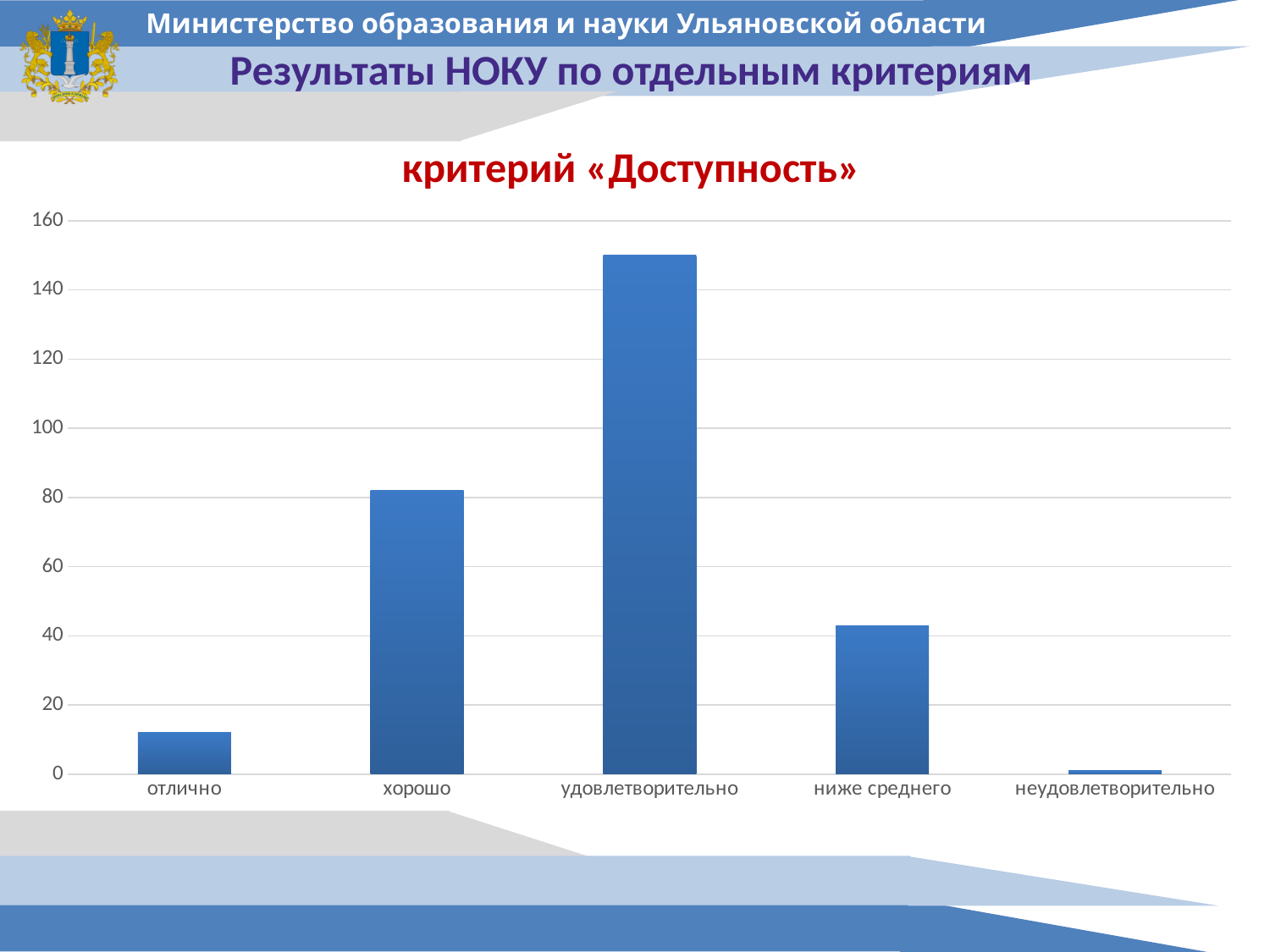
Which category has the lowest bar? неудовлетворительно Is the value for отлично greater or less than 20? less How many categories are shown on the x axis of the chart? 5 Which category has the highest bar? удовлетворительно Which is larger, the value for хорошо or the value for ниже среднего? хорошо What is the title of the chart? критерий «Доступность» What is the highest value shown on the vertical axis of the chart? 160 Which is larger, the value for отлично or the value for ниже среднего? ниже среднего Is the value for хорошо greater or less than 100? less Is the value for удовлетворительно greater or less than 140? greater What kind of chart is shown on the slide? bar chart